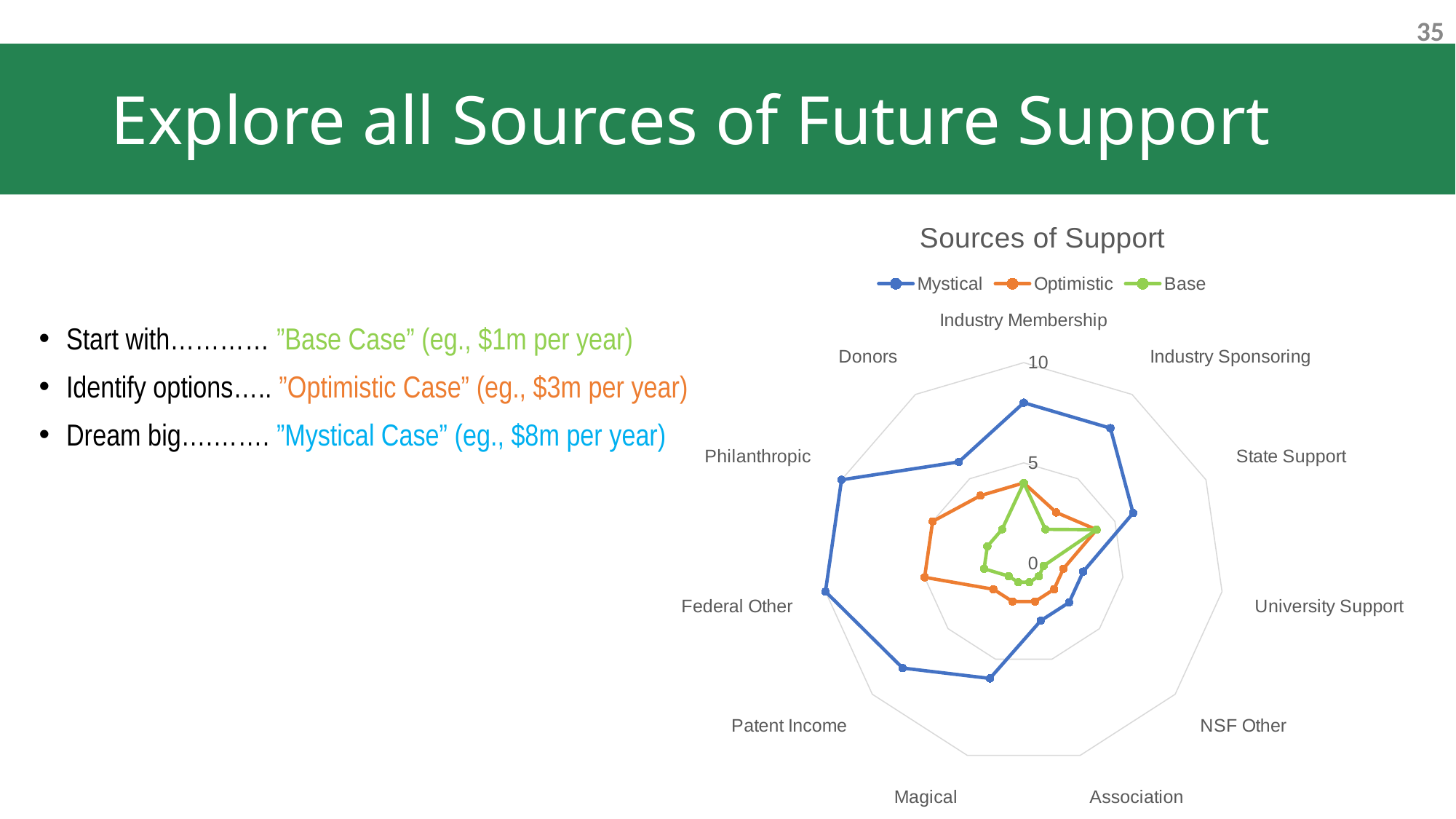
Is the Base value for Magical greater or less than 5? less For Industry Membership, which series has the larger value, Optimistic or Mystical? Mystical How many categories are plotted around the radar chart? 11 For Federal Other, which series has the larger value, Mystical or Base? Mystical Is the Mystical value for Federal Other greater or less than 5? greater How many series does the chart's legend list? 3 Is the Mystical value for University Support greater or less than 5? less Which series is drawn in blue in the chart? Mystical What kind of chart is shown on the slide? Radar chart What is the title of the chart? Sources of Support